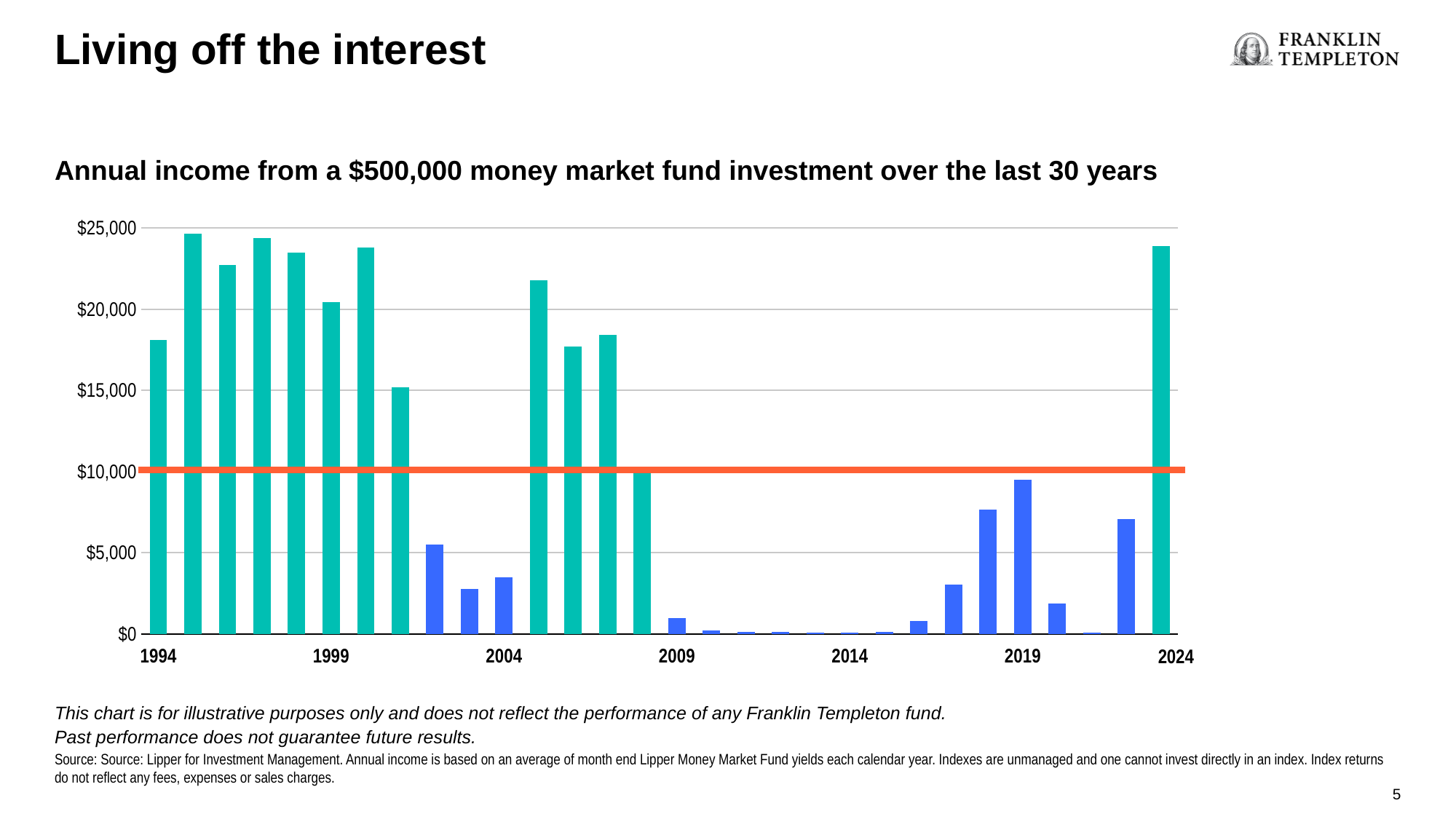
Is the value for 2019 greater or less than $10,000? less Do the values rise or fall from 2019 to 2021? fall What is the title of the chart? Annual income from a $500,000 money market fund investment over the last 30 years Which is larger, the value for 2018 or the value for 2019? 2019 Is the value for 2005 greater or less than $20,000? greater At what value on the y axis is the horizontal orange line drawn? $10,000 Do the values rise or fall from 2016 to 2019? rise What kind of chart is shown on the slide? Bar chart Is the value for 1994 greater or less than $15,000? greater Which is larger, the value for 1994 or the value for 1995? 1995